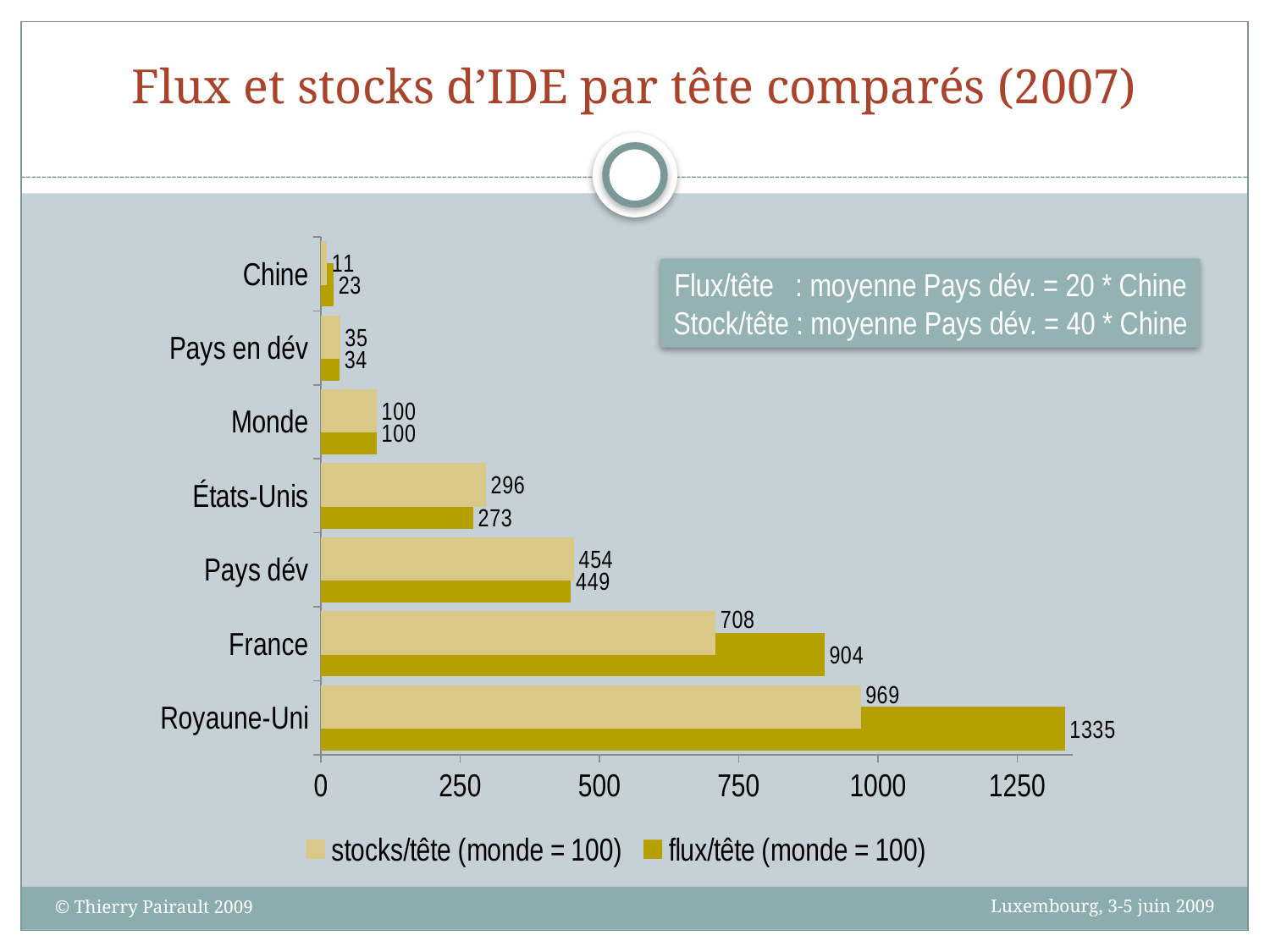
What is the stocks/tête value for États-Unis? 296 What is the title of the slide containing the chart? Flux et stocks d'IDE par tête comparés (2007) What is the difference between the flux/tête and stocks/tête values for Royaune-Uni? 366 Which is larger for France: the stocks/tête value or the flux/tête value? flux/tête Which category has the lowest stocks/tête value? Chine How many series does the legend list? 2 What is the flux/tête value for Chine? 23 What is the flux/tête value for France? 904 How many categories are plotted on the chart? 7 What kind of chart is shown on the slide? bar chart Is the stocks/tête value for Pays dév greater or less than 500? less Which category has the highest flux/tête value? Royaune-Uni